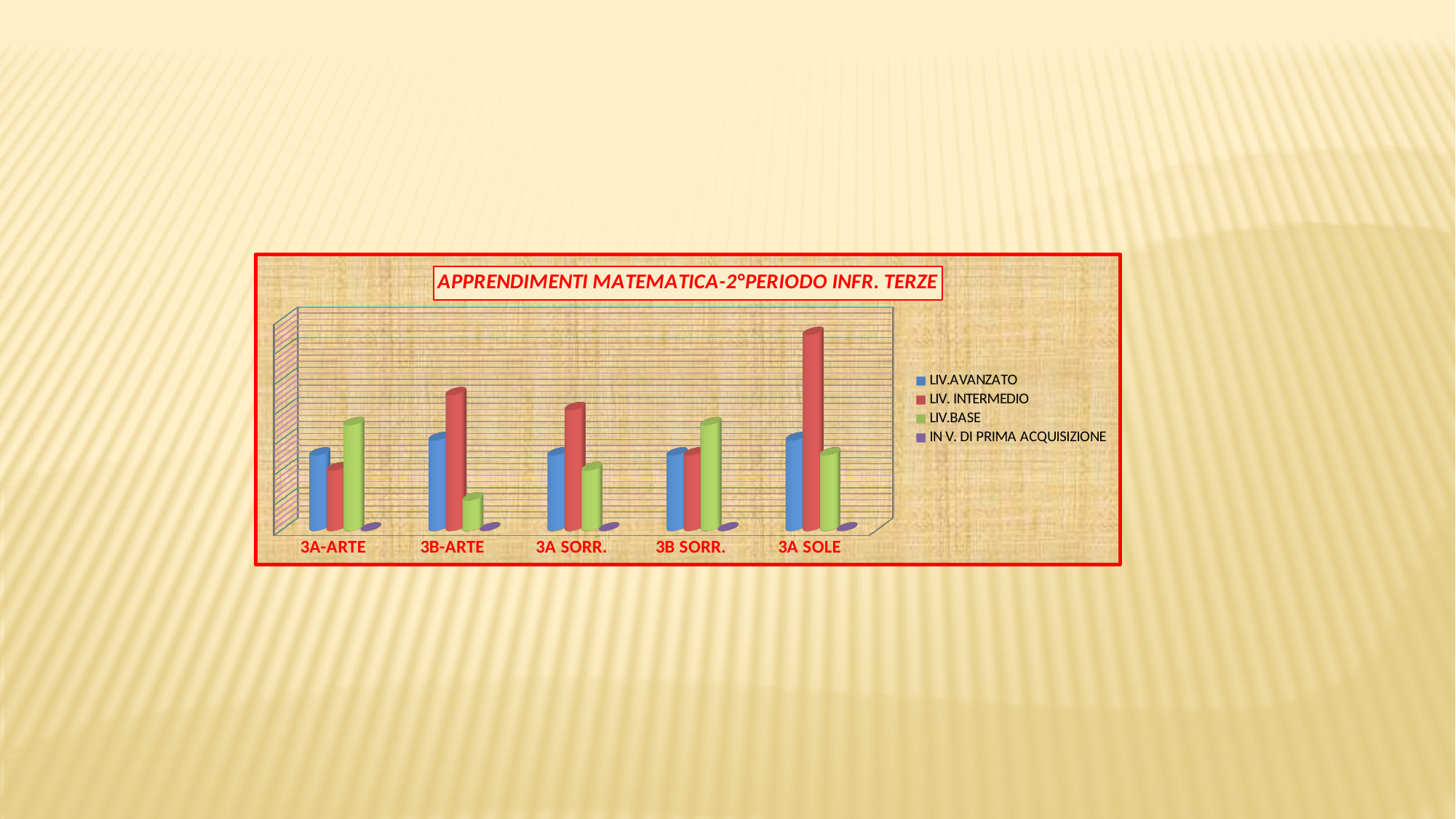
Which class has the highest LIV. INTERMEDIO bar? 3A SOLE For 3A-ARTE, which is larger: LIV.BASE or LIV. INTERMEDIO? LIV.BASE For 3B-ARTE, which is larger: LIV. INTERMEDIO or LIV.AVANZATO? LIV. INTERMEDIO Which legend entry is shown in purple? IN V. DI PRIMA ACQUISIZIONE What is the title of the chart? APPRENDIMENTI MATEMATICA-2°PERIODO INFR. TERZE Which series has the lowest bar in every class? IN V. DI PRIMA ACQUISIZIONE How many series does the chart's legend list? 4 How many categories (classes) are shown on the x axis of the chart? 5 Which class has the lowest LIV.BASE bar? 3B-ARTE For 3B SORR., which is larger: LIV.BASE or LIV.AVANZATO? LIV.BASE What kind of chart is shown on the slide? bar chart Which series has the tallest bar for 3A SOLE? LIV. INTERMEDIO